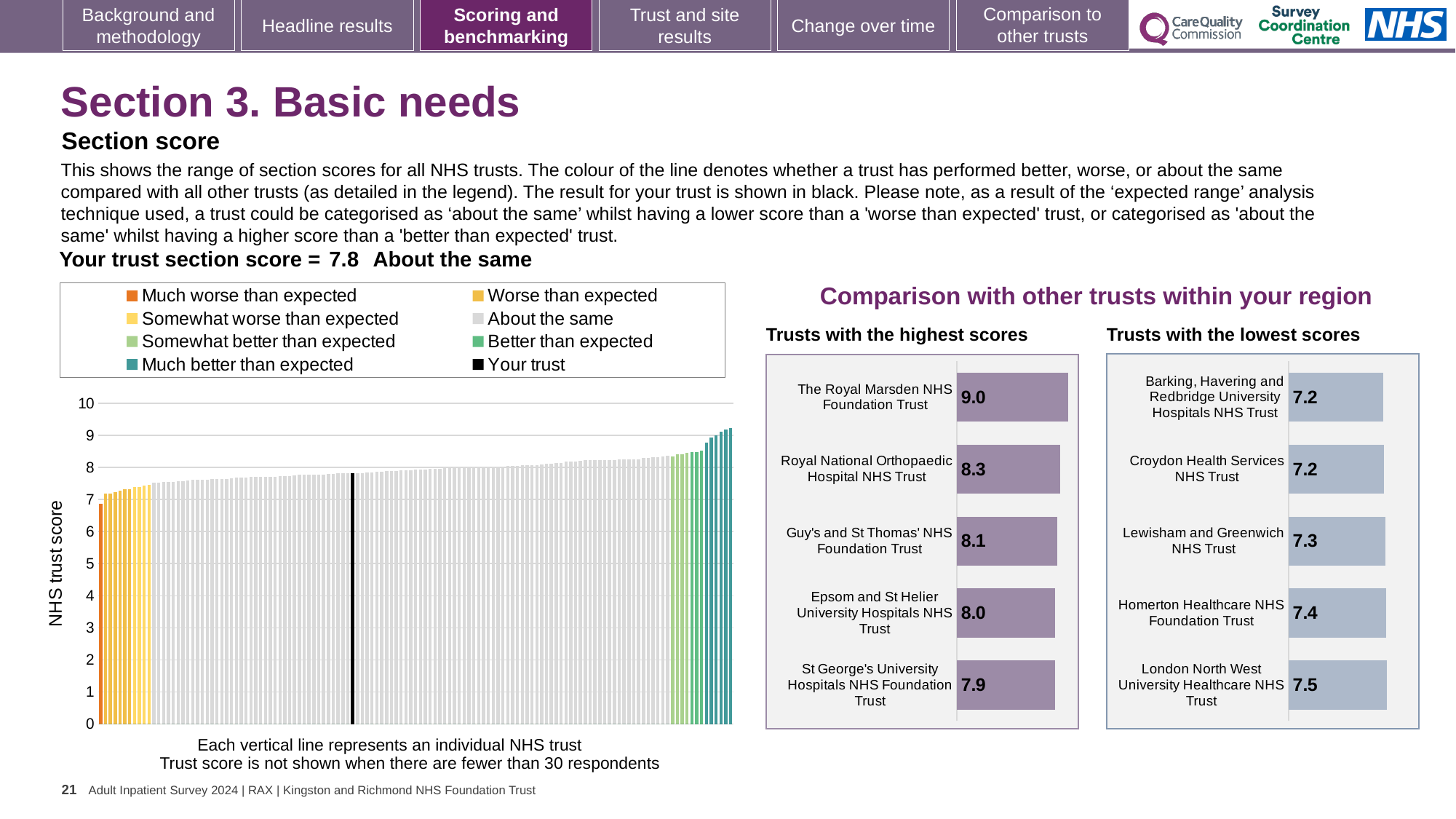
In the left-hand chart, is the value for the black bar (your trust) greater or less than 7? greater In the 'Trusts with the highest scores' chart, how many trusts are shown? 5 In the left-hand chart, do the trust scores rise or fall from left to right along the x axis? rise In the 'Trusts with the highest scores' chart, which trust has the highest score? The Royal Marsden NHS Foundation Trust In the 'Trusts with the lowest scores' chart, which trust has the highest score? London North West University Healthcare NHS Trust What kind of chart is the large chart on the left showing NHS trust scores? bar chart What is your trust's section score for Basic needs as stated on the slide? 7.8 In the 'Trusts with the lowest scores' chart, which has the larger score: Lewisham and Greenwich NHS Trust or Croydon Health Services NHS Trust? Lewisham and Greenwich NHS Trust How many entries does the legend of the left-hand chart list? 8 In the 'Trusts with the highest scores' chart, what is the score for The Royal Marsden NHS Foundation Trust? 9.0 In the 'Trusts with the lowest scores' chart, what is the score for Homerton Healthcare NHS Foundation Trust? 7.4 In the 'Trusts with the highest scores' chart, what is the difference between the scores of The Royal Marsden NHS Foundation Trust and Royal National Orthopaedic Hospital NHS Trust? 0.7